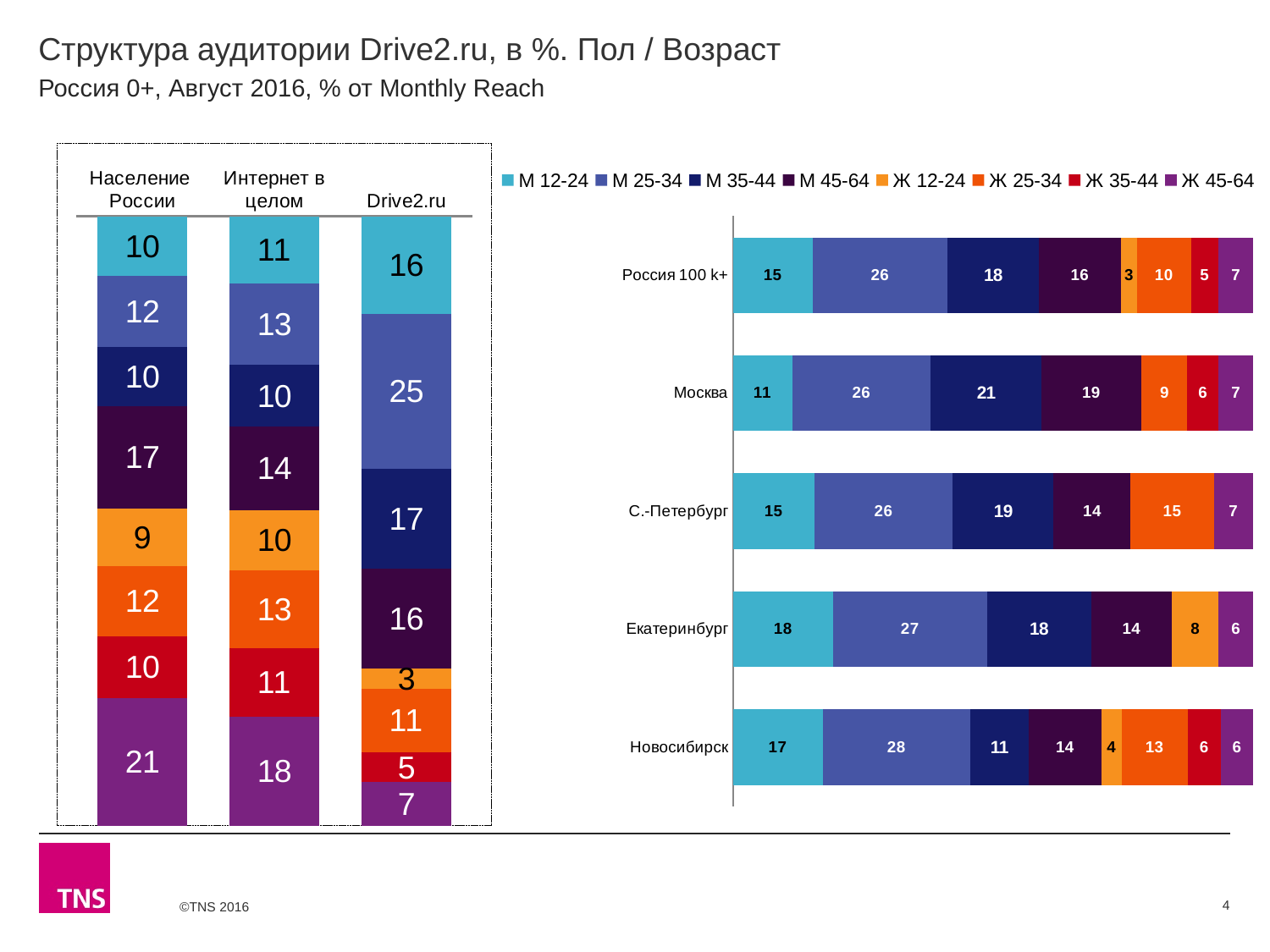
In the right-hand chart, which is larger: the М 45-64 value for Москва or for Екатеринбург? Москва How many rows (categories) are shown in the right-hand chart? 5 In the right-hand chart, what is the difference between the М 25-34 values for Екатеринбург and Россия 100 k+? 1 In the right-hand chart, which city has the highest М 12-24 value? Екатеринбург In the left-hand chart, what is the value of the bottom (Ж 45-64) segment of the Drive2.ru bar? 7 What type of chart is the left-hand chart? Stacked bar chart In the left-hand chart, what is the value of the top (М 12-24) segment of the Население России bar? 10 In the right-hand chart, which row has the lowest М 12-24 value? Москва In the right-hand chart, what is the value of the М 35-44 segment for Москва? 21 How many series does the legend of the right-hand chart list? 8 In the right-hand chart, what is the value of the М 25-34 segment for Новосибирск? 28 In the right-hand chart, what is the value of the Ж 25-34 segment for С.-Петербург? 15